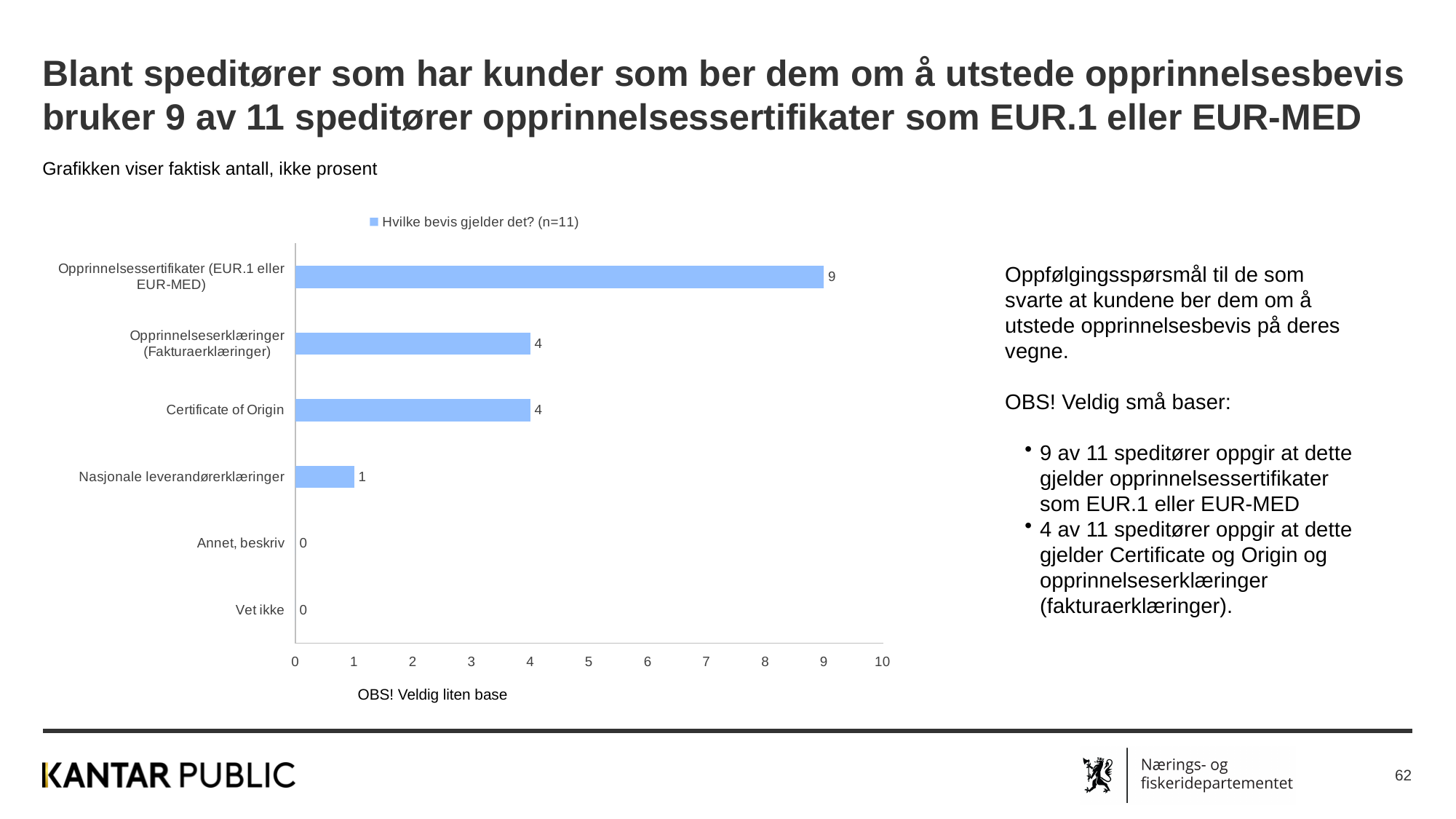
Which category has the highest value? Opprinnelsessertifikater (EUR.1 eller EUR-MED) Which is larger, the value for Certificate of Origin or the value for Nasjonale leverandørerklæringer? Certificate of Origin What is the difference between the values for Opprinnelsessertifikater (EUR.1 eller EUR-MED) and Opprinnelseserklæringer (Fakturaerklæringer)? 5 What is the value for Certificate of Origin? 4 How many categories are shown in the chart? 6 What kind of chart is shown on the slide? bar chart What is the value for Opprinnelsessertifikater (EUR.1 eller EUR-MED)? 9 How many series does the legend list? 1 What is the value for Vet ikke? 0 Is the value for Opprinnelsessertifikater (EUR.1 eller EUR-MED) greater or less than 5? greater What is the legend entry of the chart? Hvilke bevis gjelder det? (n=11) What is the value for Nasjonale leverandørerklæringer? 1